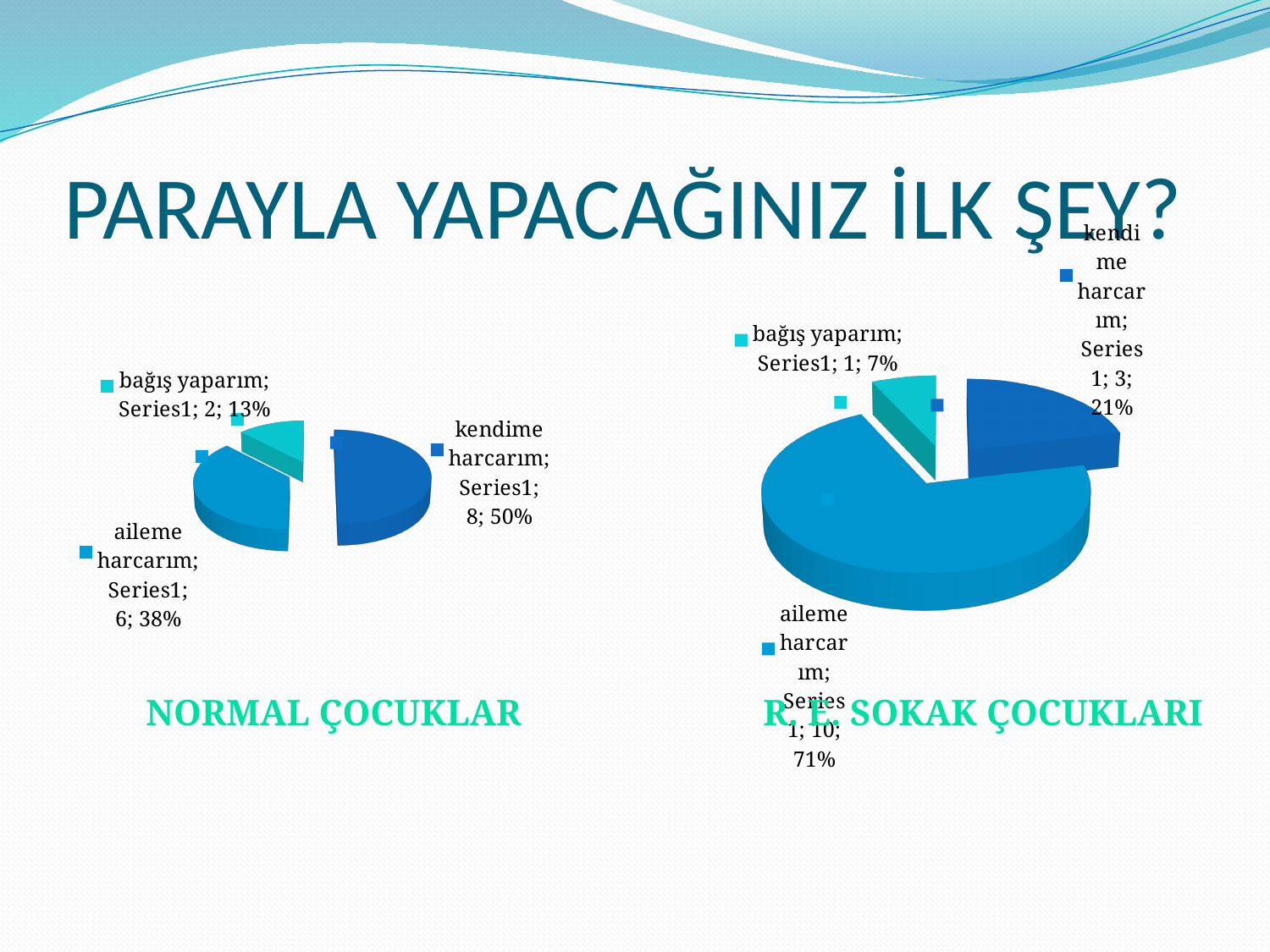
What type of chart is the NORMAL ÇOCUKLAR chart? pie chart In the NORMAL ÇOCUKLAR chart, what is the difference between the values for 'kendime harcarım' and 'aileme harcarım'? 2 What is the title of the slide containing the two charts? PARAYLA YAPACAĞINIZ İLK ŞEY? In the NORMAL ÇOCUKLAR chart, which category has the smallest slice? bağış yaparım In the R. E. SOKAK ÇOCUKLARI chart, which is larger: 'bağış yaparım' or 'kendime harcarım'? kendime harcarım In the R. E. SOKAK ÇOCUKLARI chart, which category has the largest slice? aileme harcarım In the NORMAL ÇOCUKLAR chart, what value is shown for 'kendime harcarım'? 8 In the R. E. SOKAK ÇOCUKLARI chart, what value is shown for 'aileme harcarım'? 10 How many categories does the R. E. SOKAK ÇOCUKLARI chart show? 3 In the R. E. SOKAK ÇOCUKLARI chart, what percentage share does 'kendime harcarım' have? 21% In the NORMAL ÇOCUKLAR chart, which category has the largest slice? kendime harcarım In the NORMAL ÇOCUKLAR chart, what percentage share does 'aileme harcarım' have? 38%